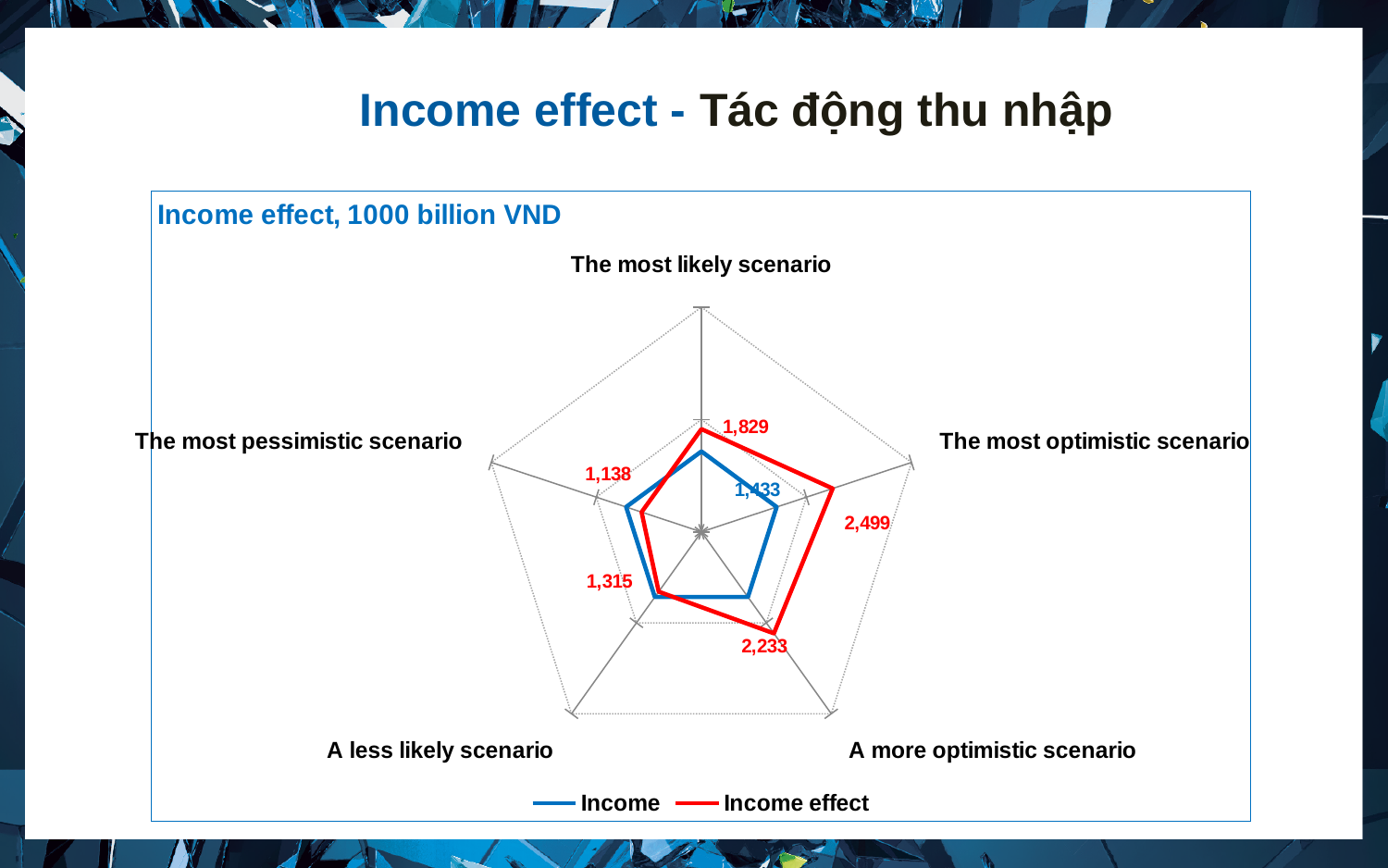
What is the Income effect value for The most likely scenario? 1,829 What is the Income effect value for A less likely scenario? 1,315 What is the Income effect value for A more optimistic scenario? 2,233 What is the Income effect value for The most optimistic scenario? 2,499 Which scenario has the lowest Income effect value? The most pessimistic scenario What is the difference between the Income effect values for The most optimistic scenario and The most pessimistic scenario? 1,361 How many series does the legend list? 2 What is the title of the chart? Income effect, 1000 billion VND Which scenario has the highest Income effect value? The most optimistic scenario What kind of chart is shown on the slide? Radar chart What is the Income effect value for The most pessimistic scenario? 1,138 How many scenarios (categories) are plotted on the radar chart? 5